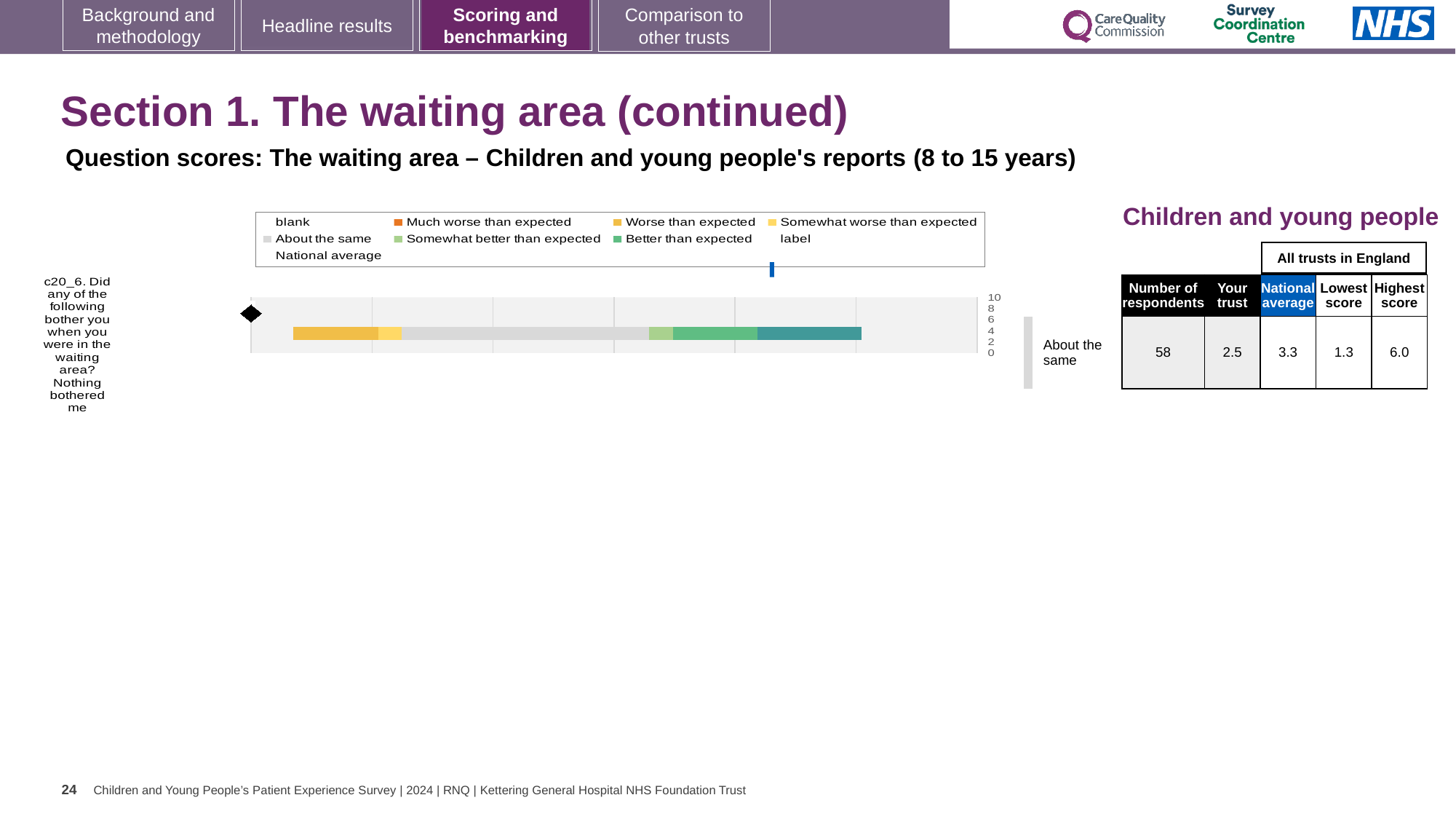
What is the difference between the National average score and the Your trust score? 0.8 What label is shown to the right of the bar chart describing the trust's result for c20_6? About the same In the table, what is the National average score? 3.3 Which question is plotted in the bar chart? c20_6. Did any of the following bother you when you were in the waiting area? Nothing bothered me In the table, what is the Highest score among all trusts in England? 6.0 What kind of chart is shown on the slide? bar chart In the table, what is the Lowest score among all trusts in England? 1.3 In the table, what is the number of respondents for c20_6? 58 Which is larger, the Your trust score or the National average score? National average What is the difference between the Highest score and the Lowest score in the table? 4.7 In the table, what is the score for Your trust? 2.5 How many question categories are plotted in the bar chart? 1